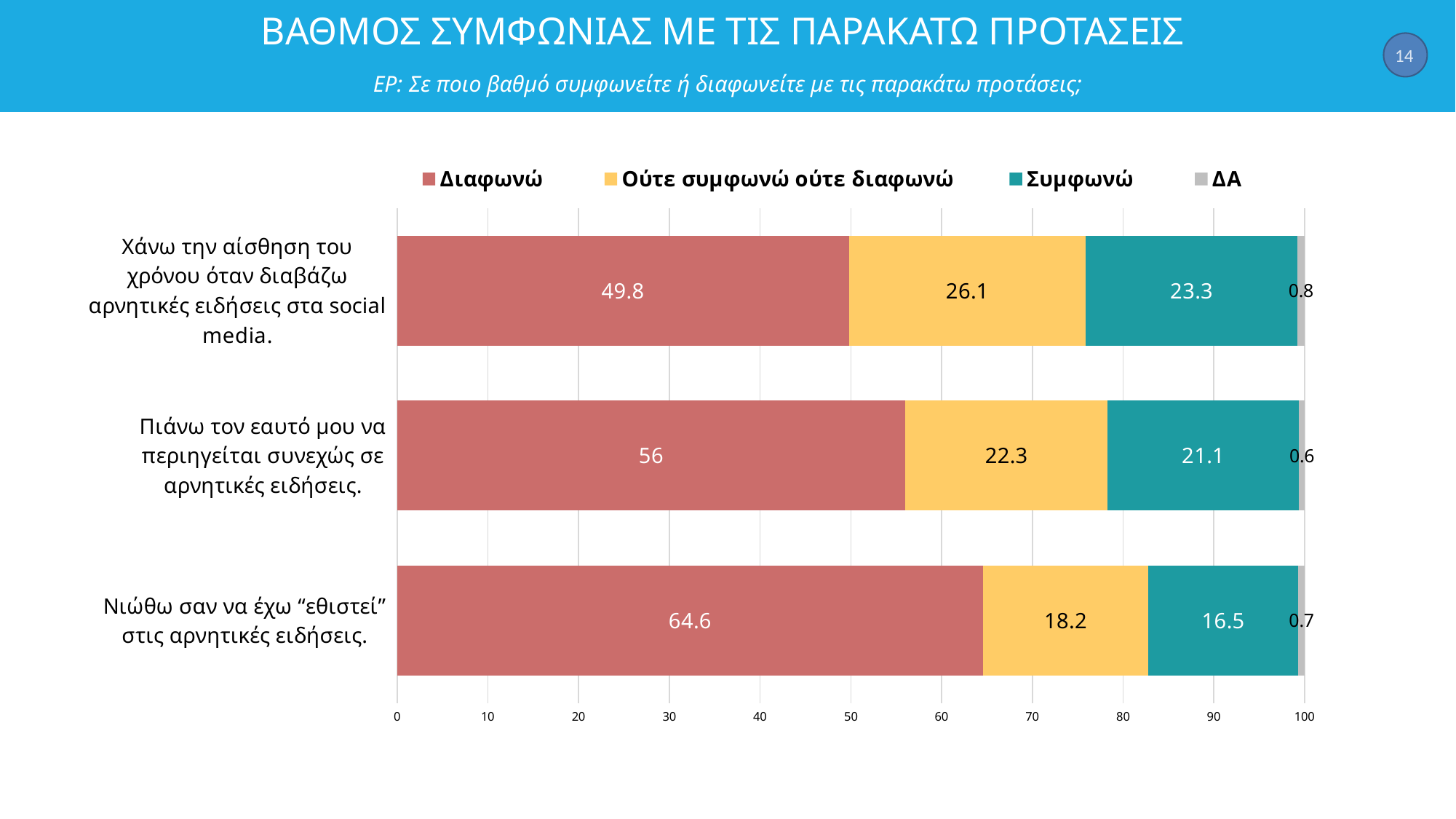
How many statements (categories) are plotted in the chart? 3 What is the value of Ούτε συμφωνώ ούτε διαφωνώ for the statement 'Χάνω την αίσθηση του χρόνου όταν διαβάζω αρνητικές ειδήσεις στα social media.'? 26.1 Which statement has the lowest Συμφωνώ value? Νιώθω σαν να έχω "εθιστεί" στις αρνητικές ειδήσεις. What is the total of the stacked bar for 'Πιάνω τον εαυτό μου να περιηγείται συνεχώς σε αρνητικές ειδήσεις.'? 100 What is the value of ΔΑ for the statement 'Χάνω την αίσθηση του χρόνου όταν διαβάζω αρνητικές ειδήσεις στα social media.'? 0.8 What is the value of Διαφωνώ for the statement 'Νιώθω σαν να έχω "εθιστεί" στις αρνητικές ειδήσεις.'? 64.6 What is the value of Συμφωνώ for the statement 'Πιάνω τον εαυτό μου να περιηγείται συνεχώς σε αρνητικές ειδήσεις.'? 21.1 Which is larger: the Συμφωνώ value for 'Χάνω την αίσθηση του χρόνου όταν διαβάζω αρνητικές ειδήσεις στα social media.' or for 'Πιάνω τον εαυτό μου να περιηγείται συνεχώς σε αρνητικές ειδήσεις.'? Χάνω την αίσθηση του χρόνου όταν διαβάζω αρνητικές ειδήσεις στα social media. What is the difference between the Διαφωνώ values for 'Νιώθω σαν να έχω "εθιστεί" στις αρνητικές ειδήσεις.' and 'Χάνω την αίσθηση του χρόνου όταν διαβάζω αρνητικές ειδήσεις στα social media.'? 14.8 Which statement has the highest Διαφωνώ value? Νιώθω σαν να έχω "εθιστεί" στις αρνητικές ειδήσεις. What type of chart is shown on the slide? Stacked bar chart How many series does the legend list? 4